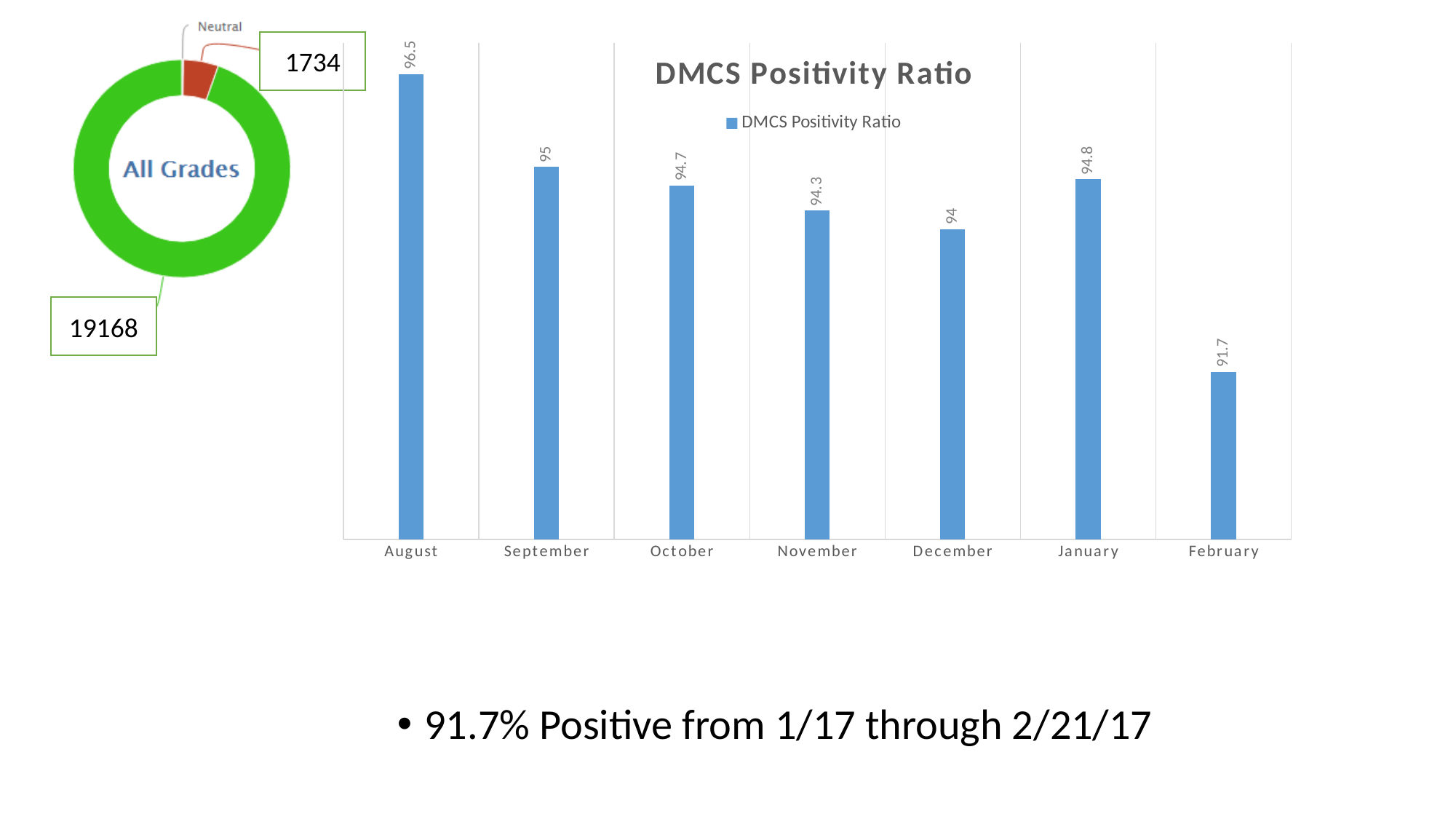
In the DMCS Positivity Ratio chart, what is the value for August? 96.5 What kind of chart is the DMCS Positivity Ratio chart? bar chart In the DMCS Positivity Ratio chart, which month has the lowest value? February How many series does the legend of the DMCS Positivity Ratio chart list? 1 In the DMCS Positivity Ratio chart, which month has the highest value? August In the All Grades donut chart on the left, what is the total of the two labelled values, 1734 and 19168? 20902 In the DMCS Positivity Ratio chart, what is the value for February? 91.7 In the DMCS Positivity Ratio chart, which is larger, the value for January or the value for December? January In the All Grades donut chart on the left, what value is shown for the Neutral segment? 1734 How many months are shown on the x axis of the DMCS Positivity Ratio chart? 7 In the DMCS Positivity Ratio chart, what is the difference between the August and February values? 4.8 In the DMCS Positivity Ratio chart, do the values overall rise or fall from August to February? fall